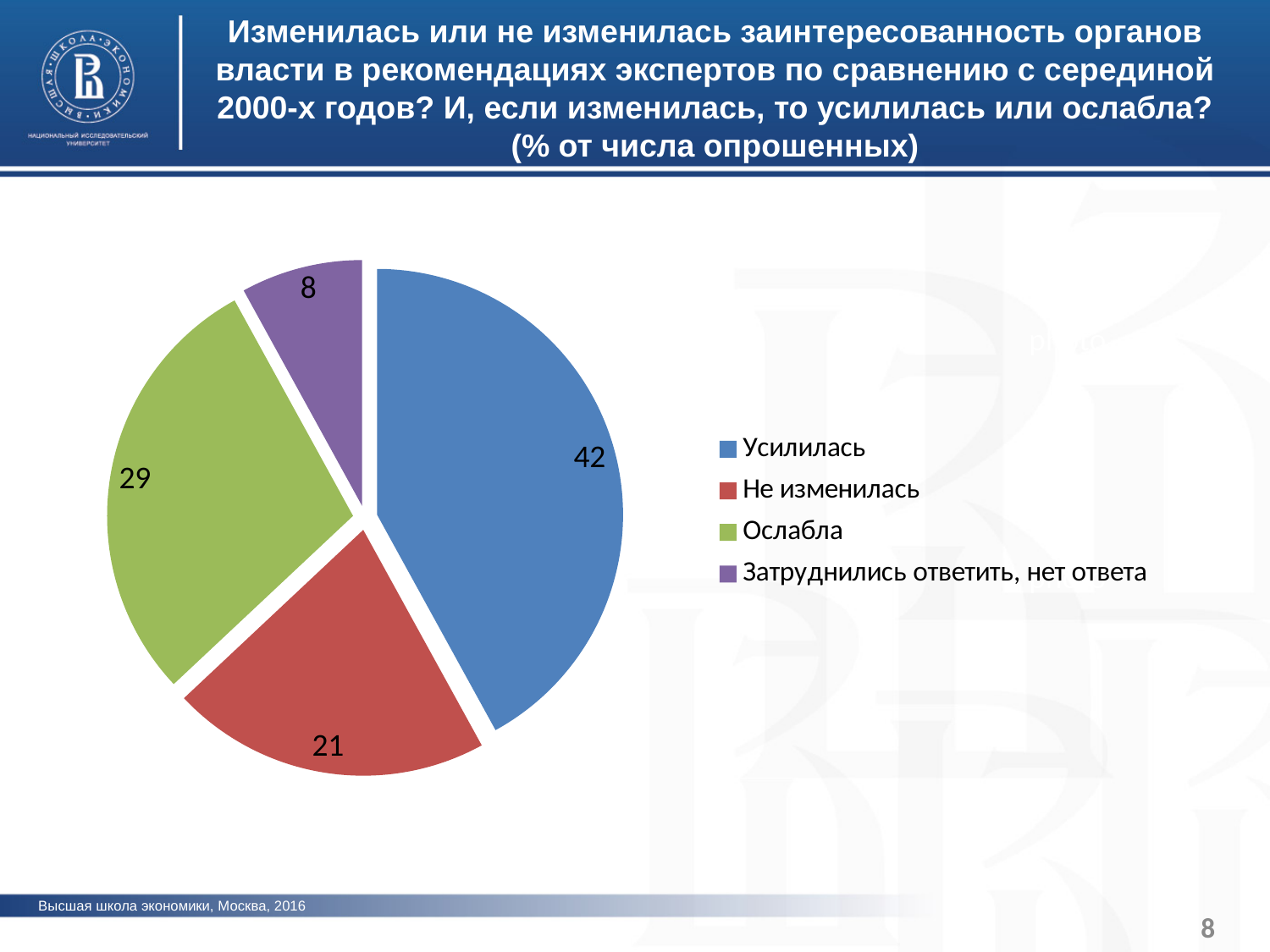
What type of chart is shown on the slide? pie chart What is the value for "Затруднились ответить, нет ответа"? 8 How many categories does the pie chart have? 4 Which category has the largest slice of the pie? Усилилась What is the total of all the slice values shown on the pie chart? 100 Which category has the smallest slice of the pie? Затруднились ответить, нет ответа What is the value for "Не изменилась"? 21 What colour is the slice for "Ослабла"? green What is the difference between the values for "Усилилась" and "Ослабла"? 13 What is the value for "Ослабла"? 29 Which is larger, the value for "Ослабла" or the value for "Не изменилась"? Ослабла What is the value for "Усилилась"? 42